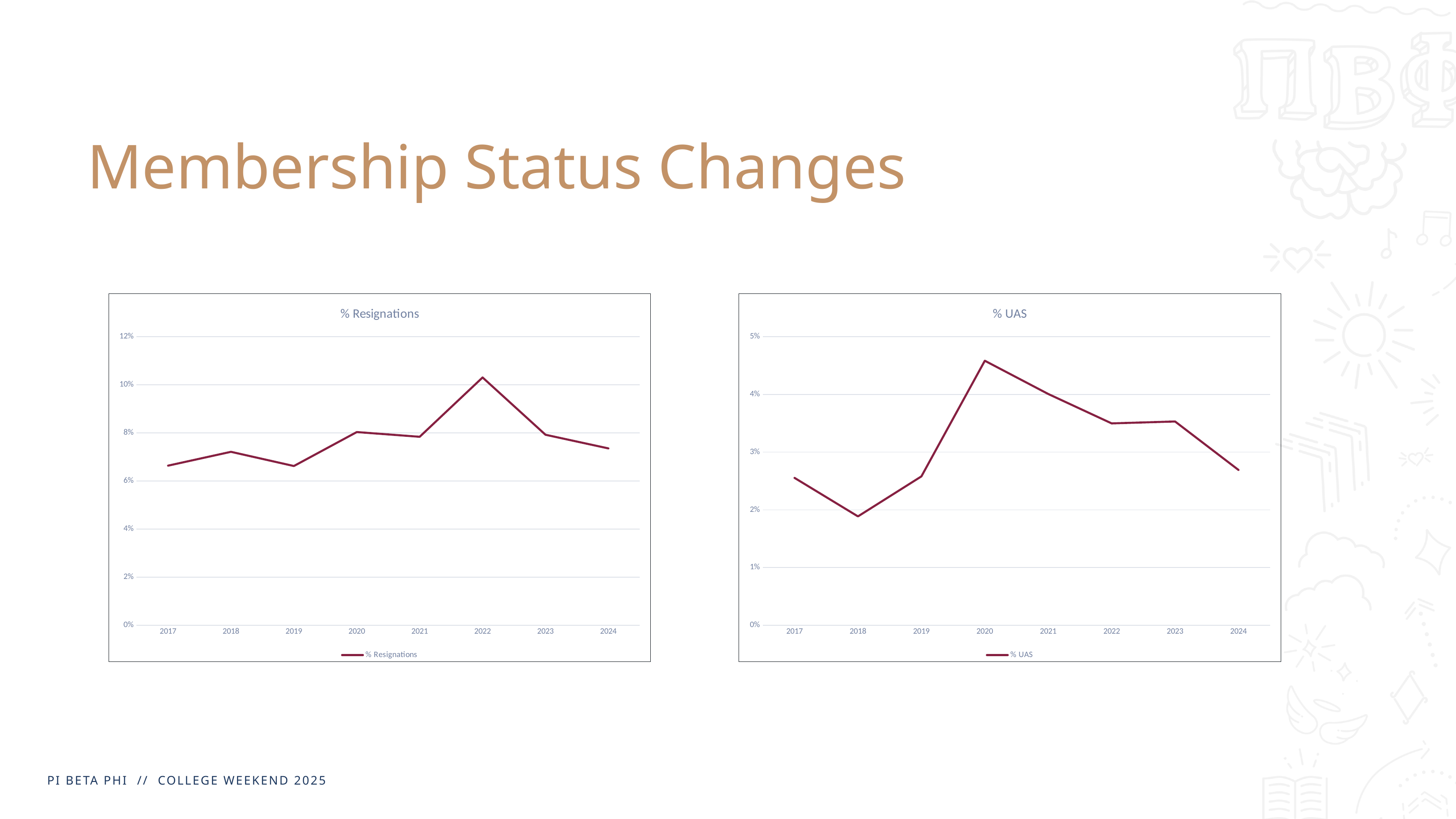
In the % UAS chart, is the value for 2020 greater or less than 4%? greater In the % UAS chart, which year has the highest value? 2020 What kind of chart is the % Resignations chart? line chart In the % UAS chart, is the value for 2018 greater or less than 2%? less In the % Resignations chart, is the value for 2018 greater or less than 8%? less In the % UAS chart, which year has the lowest value? 2018 How many years are plotted on the x axis of the % Resignations chart? 8 In the % Resignations chart, which year has the highest value? 2022 In the % Resignations chart, which is larger, the value for 2022 or the value for 2024? 2022 How many series does the legend of the % UAS chart list? 1 In the % UAS chart, do the values rise or fall from 2020 to 2024? fall